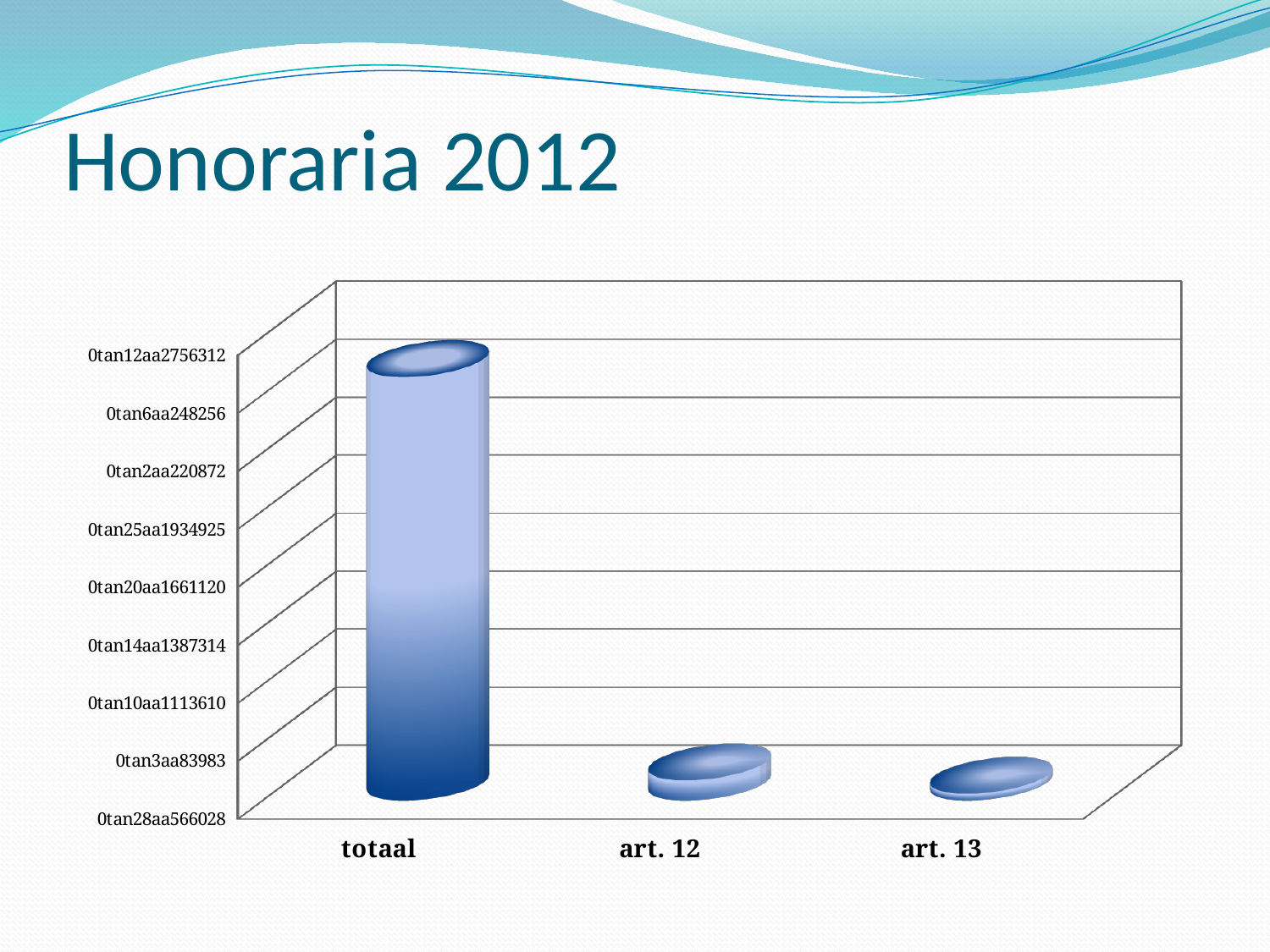
Which is larger, the value for totaal or the value for art. 12? totaal Which is larger, the value for totaal or the value for art. 13? totaal Do the values rise or fall from totaal to art. 12 along the x axis? fall What is the title of the slide containing the chart? Honoraria 2012 Which category has the highest value in the chart? totaal What are the three category labels on the x axis of the chart? totaal, art. 12, art. 13 How many categories are shown on the x axis of the chart? 3 What kind of chart is shown on the slide? bar chart